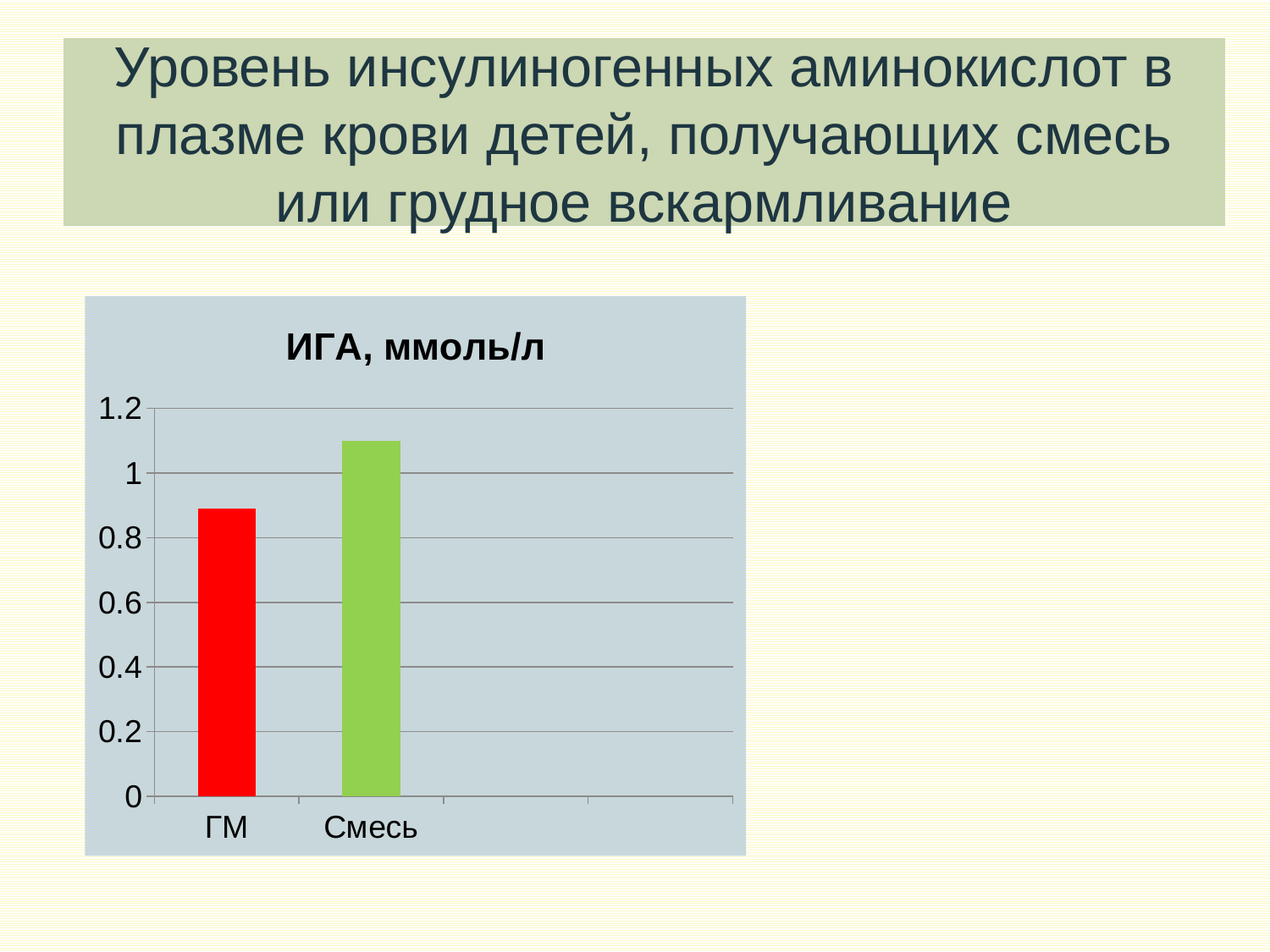
Is the value for Смесь greater or less than 1.2? less Is the value for ГМ greater or less than 0.8? greater What is the highest tick value shown on the vertical axis? 1.2 Which category has the highest value in the chart? Смесь What is the title of the chart? ИГА, ммоль/л Is the value for Смесь greater or less than 1? greater What kind of chart is shown on the slide? bar chart What colour is the bar for ГМ? red Which category has the lowest value in the chart? ГМ How many bars (categories) are plotted in the chart? 2 Which is larger, the value for ГМ or the value for Смесь? Смесь